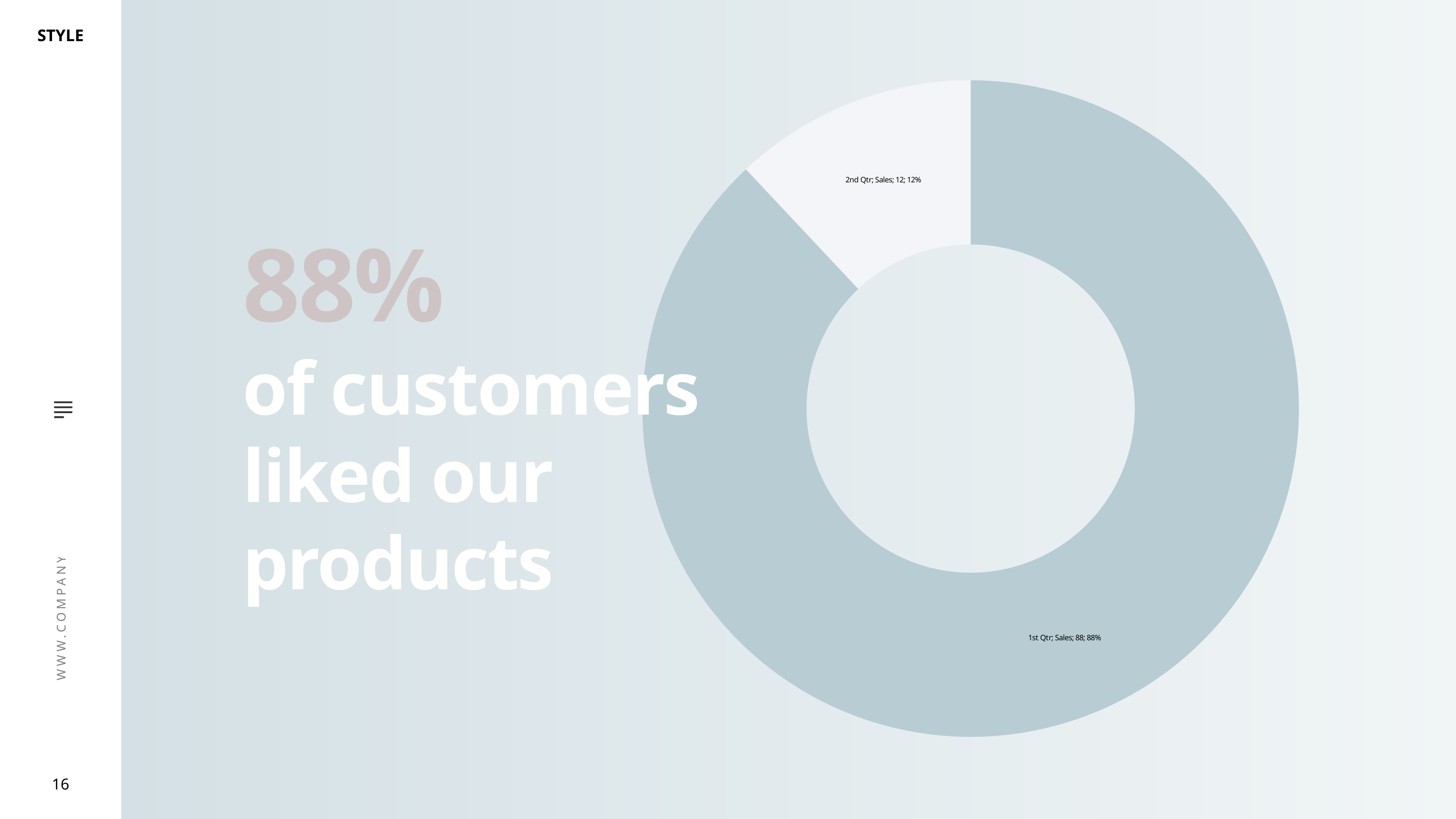
What is the Sales value for 1st Qtr? 88 Which category has the smallest slice? 2nd Qtr How many categories are shown in the chart? 2 What is the name of the data series shown in the chart's data labels? Sales What kind of chart is shown on the slide? Doughnut chart What is the total of the Sales values across both slices? 100 What is the Sales value for 2nd Qtr? 12 What percentage share does the 1st Qtr slice represent? 88% What percentage share does the 2nd Qtr slice represent? 12% Which category has the largest slice? 1st Qtr What is the difference between the Sales values for 1st Qtr and 2nd Qtr? 76 Which is larger, the Sales value for 1st Qtr or for 2nd Qtr? 1st Qtr